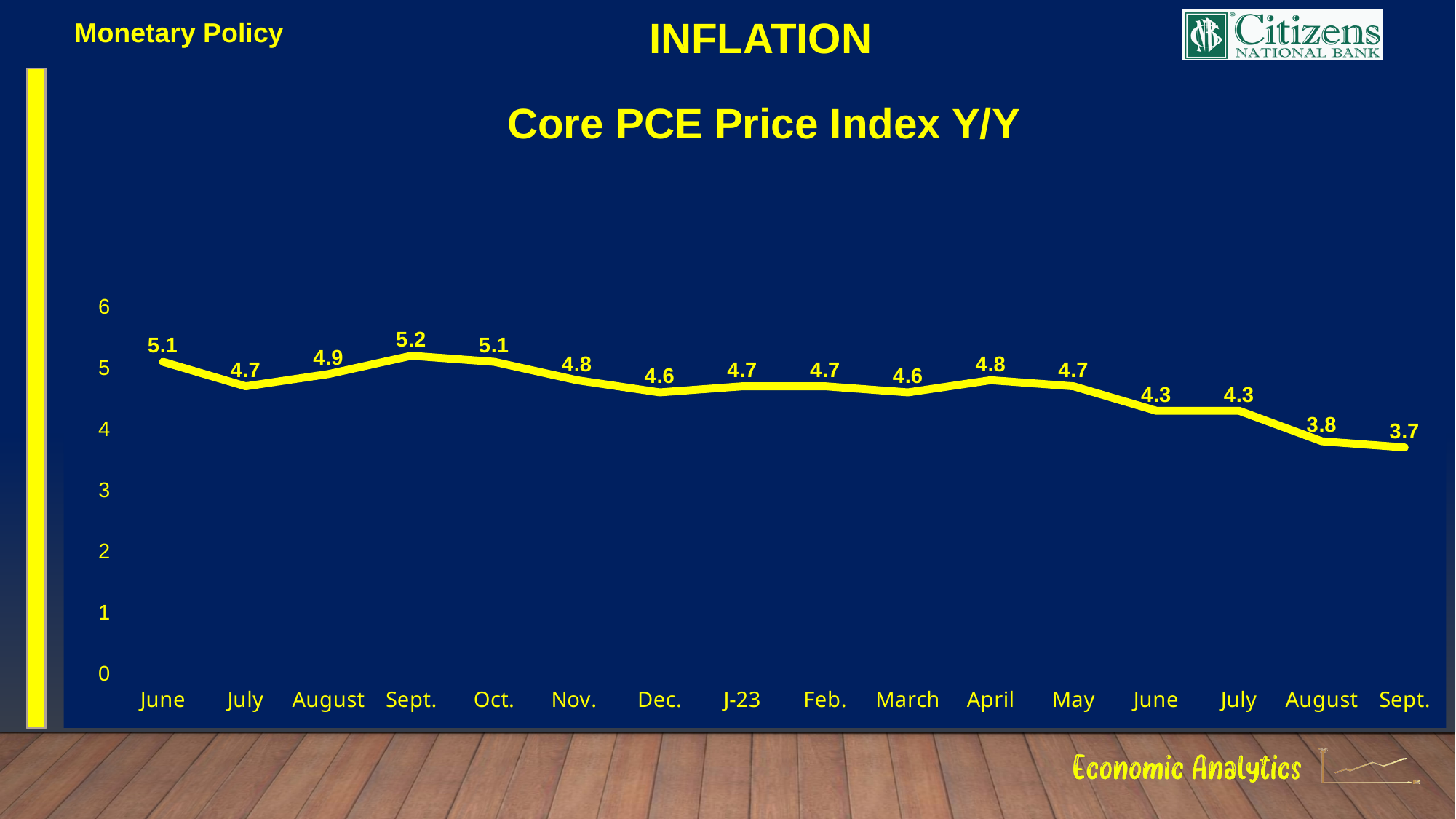
What kind of chart is shown on the slide? line chart What is the highest value shown on the line? 5.2 What is the difference between the first point (June, 5.1) and the last point (Sept., 3.7)? 1.4 What is the lowest value shown on the line? 3.7 What is the title of the chart? Core PCE Price Index Y/Y Overall, does the line rise or fall from the first June to the last Sept.? fall Which has the larger value, April or May? April Is the value for March greater or less than 5? less What is the value plotted for April? 4.8 How many data points are plotted on the Core PCE Price Index Y/Y line? 16 What is the value plotted for Dec.? 4.6 What is the Core PCE Price Index Y/Y value for J-23? 4.7